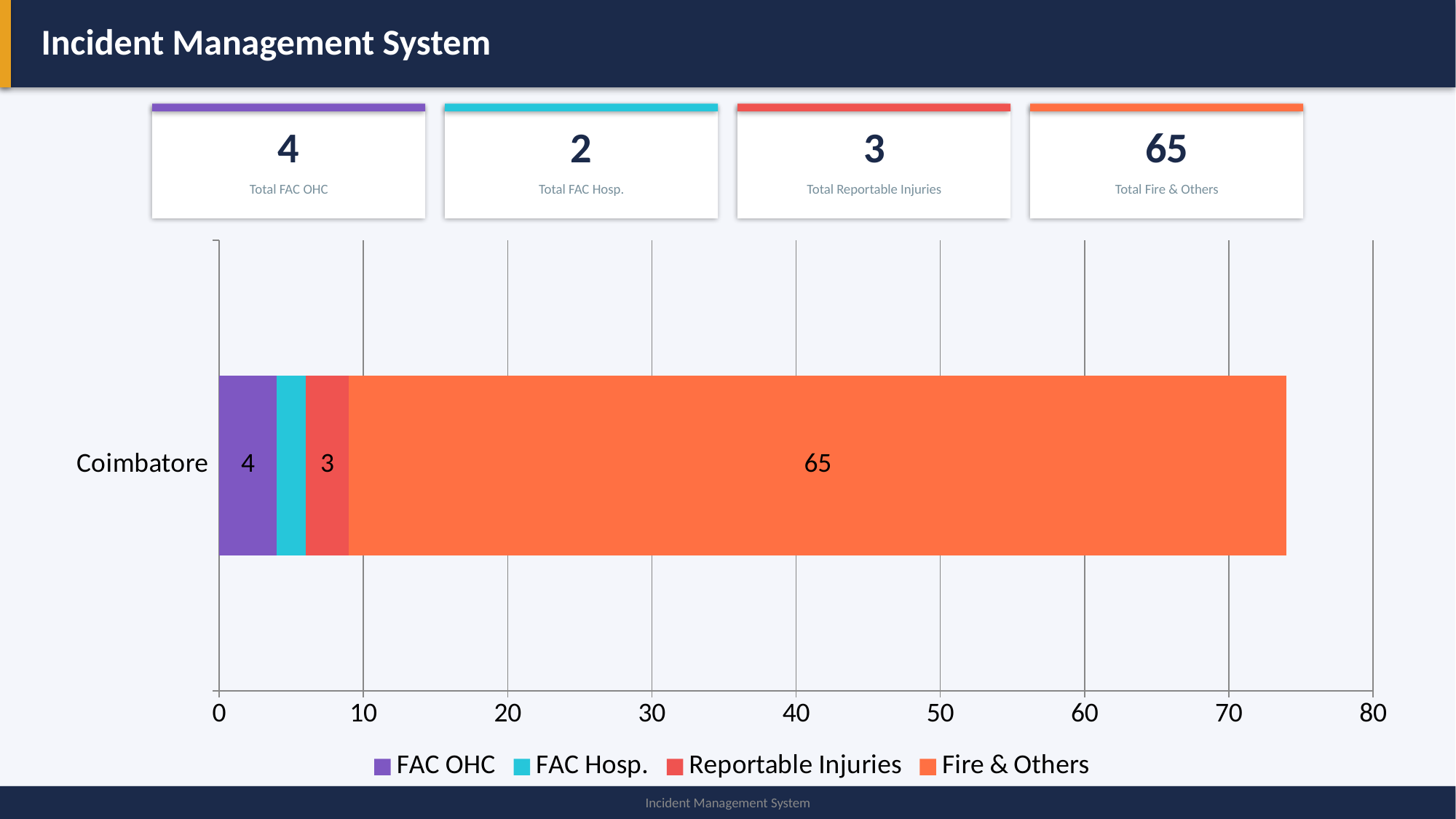
What is the FAC OHC value for Coimbatore? 4 What is the difference between the Fire & Others value and the FAC OHC value for Coimbatore? 61 What is the Reportable Injuries value for Coimbatore? 3 What is the Fire & Others value for Coimbatore? 65 How many categories are plotted on the y axis of the chart? 1 How many series does the chart legend list? 4 Which series has the largest segment in the Coimbatore bar? Fire & Others What is the name of the category shown on the y axis of the chart? Coimbatore Is the total length of the Coimbatore stacked bar greater or less than 70? greater What kind of chart is shown on the slide? bar chart What is the difference between the Fire & Others value and the Reportable Injuries value for Coimbatore? 62 Which is larger for Coimbatore, FAC OHC or Reportable Injuries? FAC OHC